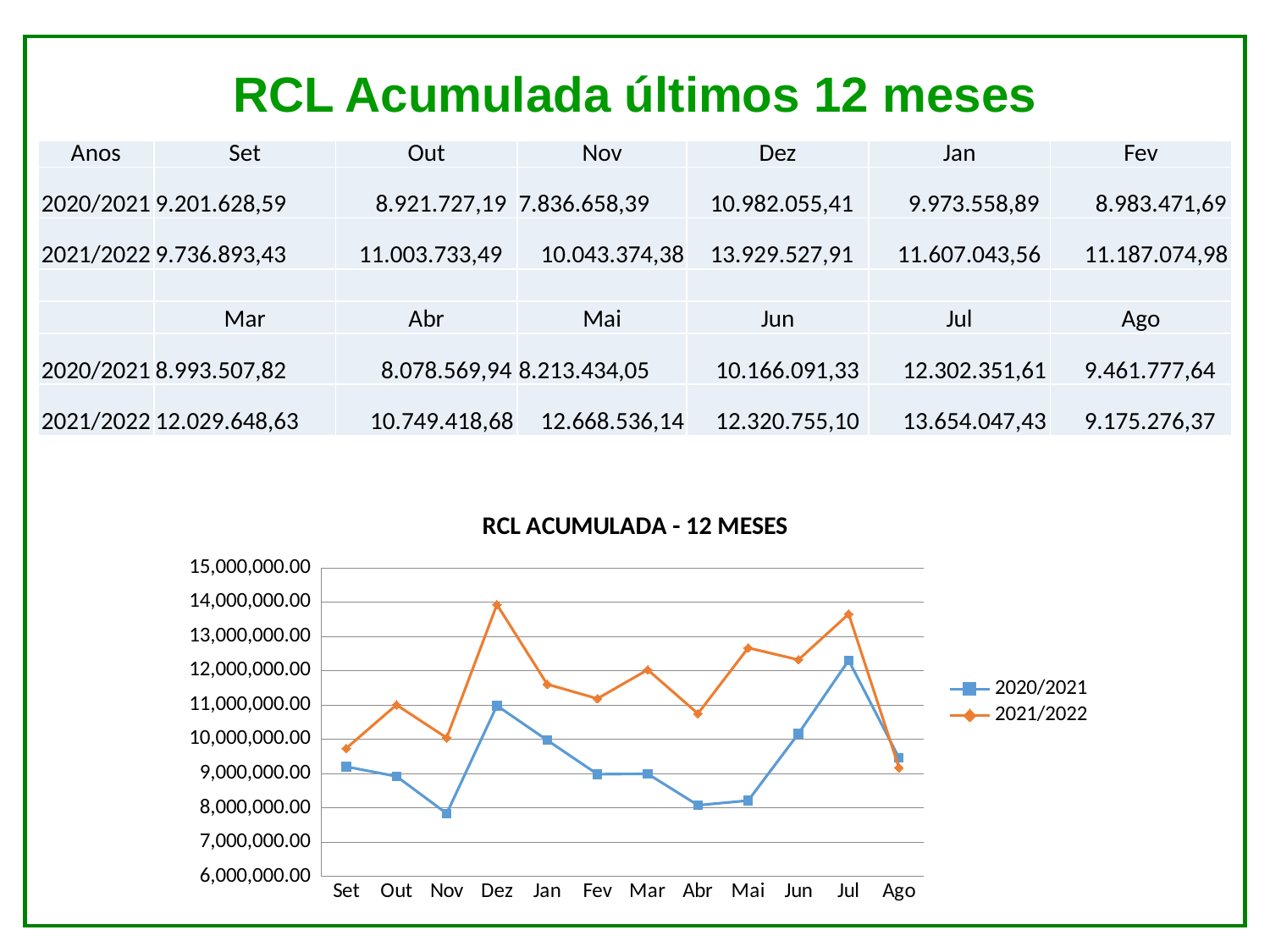
In Ago, which series has the larger value, 2020/2021 or 2021/2022? 2020/2021 Does the 2020/2021 series rise or fall from Set to Nov? fall In which month does the 2021/2022 series reach its lowest value? Ago What type of chart is shown under the title 'RCL ACUMULADA - 12 MESES'? line chart In which month does the 2021/2022 series reach its highest value? Dez What is the value of the 2021/2022 series in Dez, as printed in the table? 13.929.527,91 Is the 2020/2021 value for Nov greater or less than 8,000,000.00? less How many months are plotted along the x axis of the 'RCL ACUMULADA - 12 MESES' chart? 12 How many series does the legend of the 'RCL ACUMULADA - 12 MESES' chart list? 2 What is the value of the 2020/2021 series in Nov, as printed in the table? 7.836.658,39 In which month does the 2020/2021 series reach its lowest value? Nov In which month does the 2020/2021 series reach its highest value? Jul